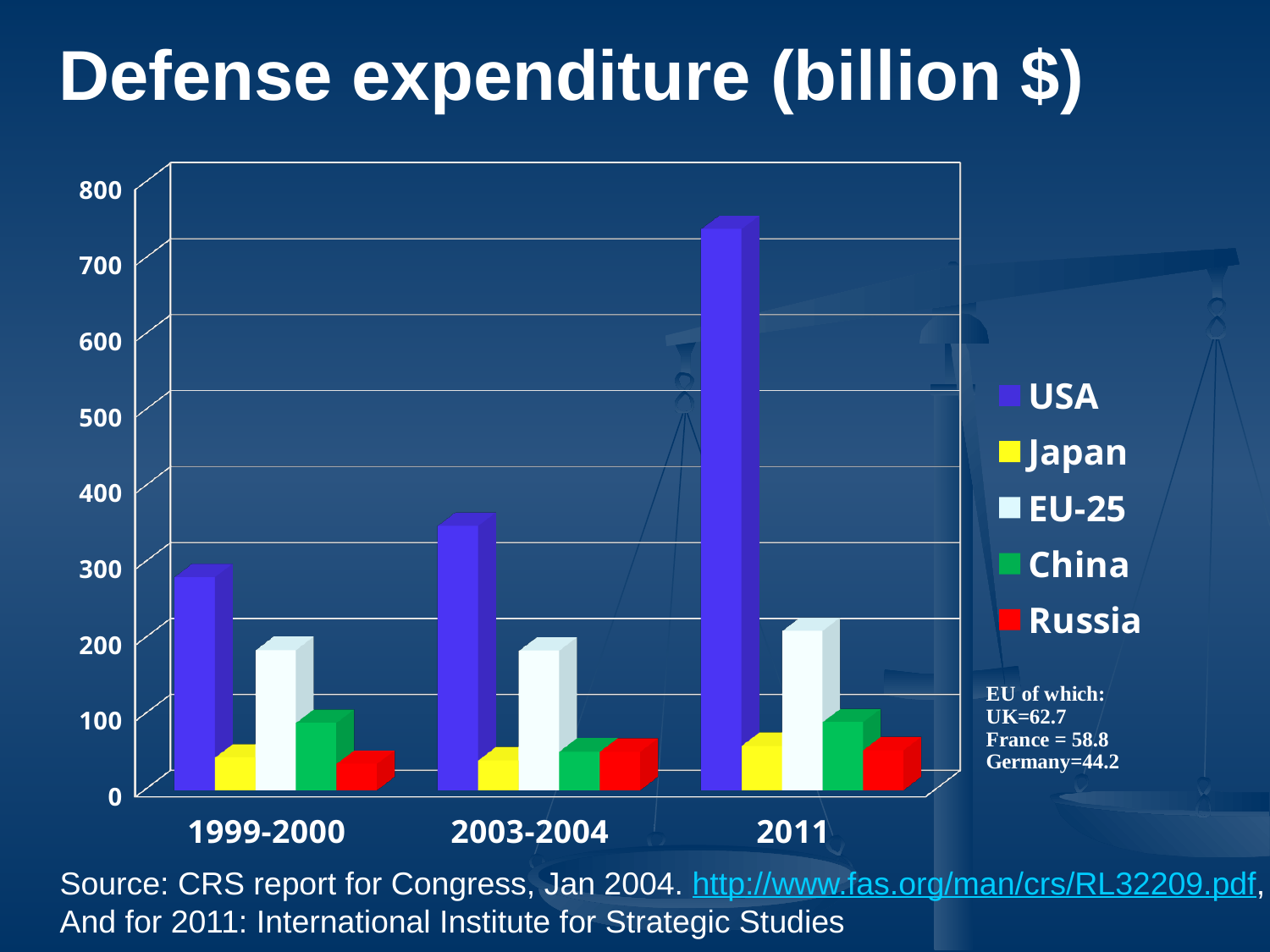
Which series has the highest value in 2011? USA How many series does the legend list? 5 How many time periods are shown on the x axis? 3 Do the USA values rise or fall from 1999-2000 to 2011? rise Is the value for USA in 2003-2004 greater or less than 400? less Which is larger in 2011, EU-25 or China? EU-25 Which series has the highest value in 1999-2000? USA What kind of chart is shown on the slide? bar chart According to the note beside the legend, what is the UK's defense expenditure within the EU figure? 62.7 Is the value for USA in 2011 greater or less than 700? greater Is the value for Japan in 1999-2000 greater or less than 100? less